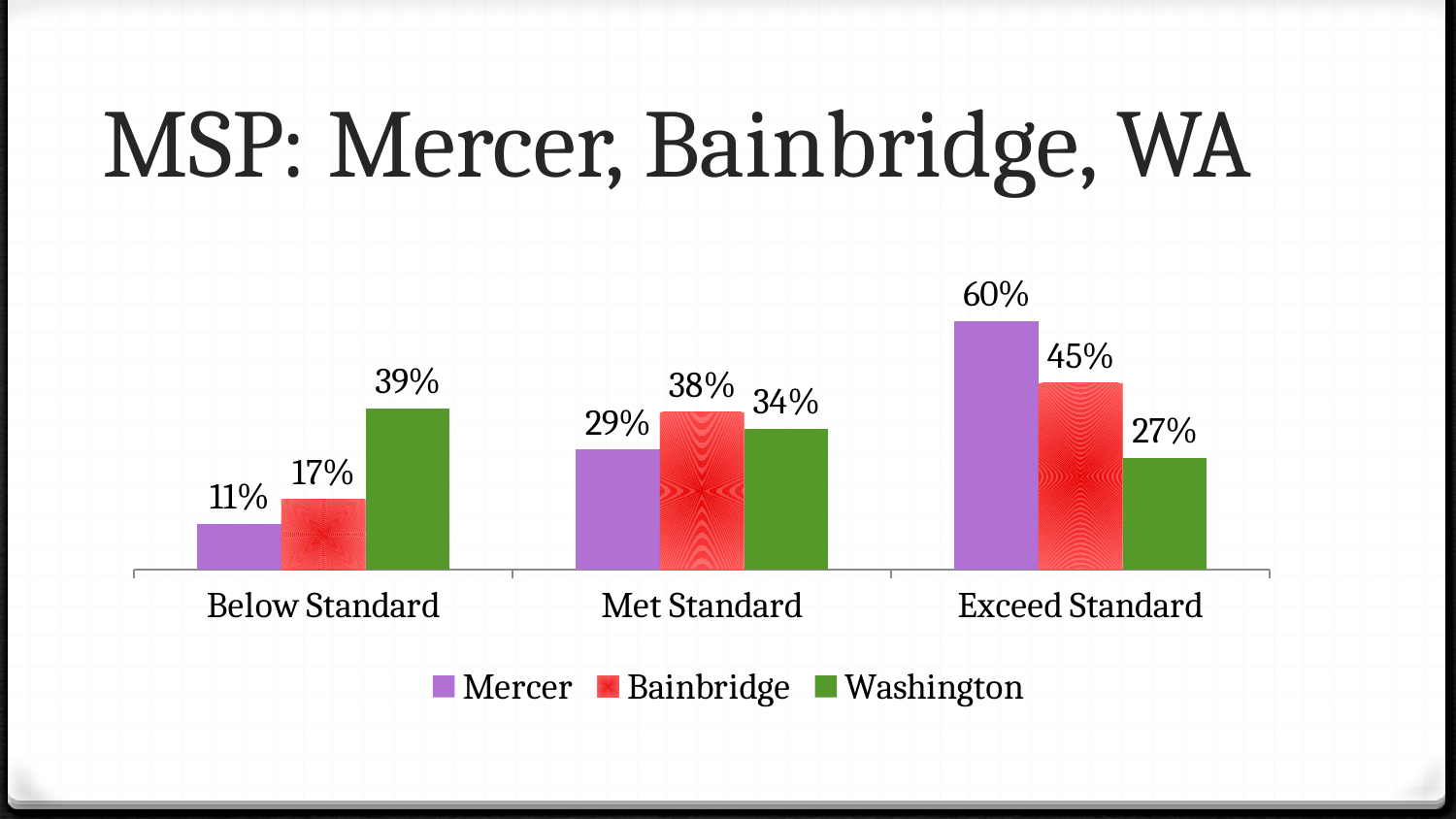
Which series has the lowest value in the Below Standard category? Mercer How many categories are shown on the x axis? 3 What is the difference between Washington and Mercer in the Below Standard category? 28% What kind of chart is shown on the slide? Bar chart What is the value for Bainbridge in the Met Standard category? 38% Which series has the highest value in the Exceed Standard category? Mercer What is the difference between Mercer and Washington in the Exceed Standard category? 33% What is the value for Mercer in the Exceed Standard category? 60% What is the value for Washington in the Below Standard category? 39% How many series does the legend list? 3 Which is larger in the Met Standard category, Bainbridge or Washington? Bainbridge Do the Mercer values rise or fall from Below Standard to Exceed Standard? Rise